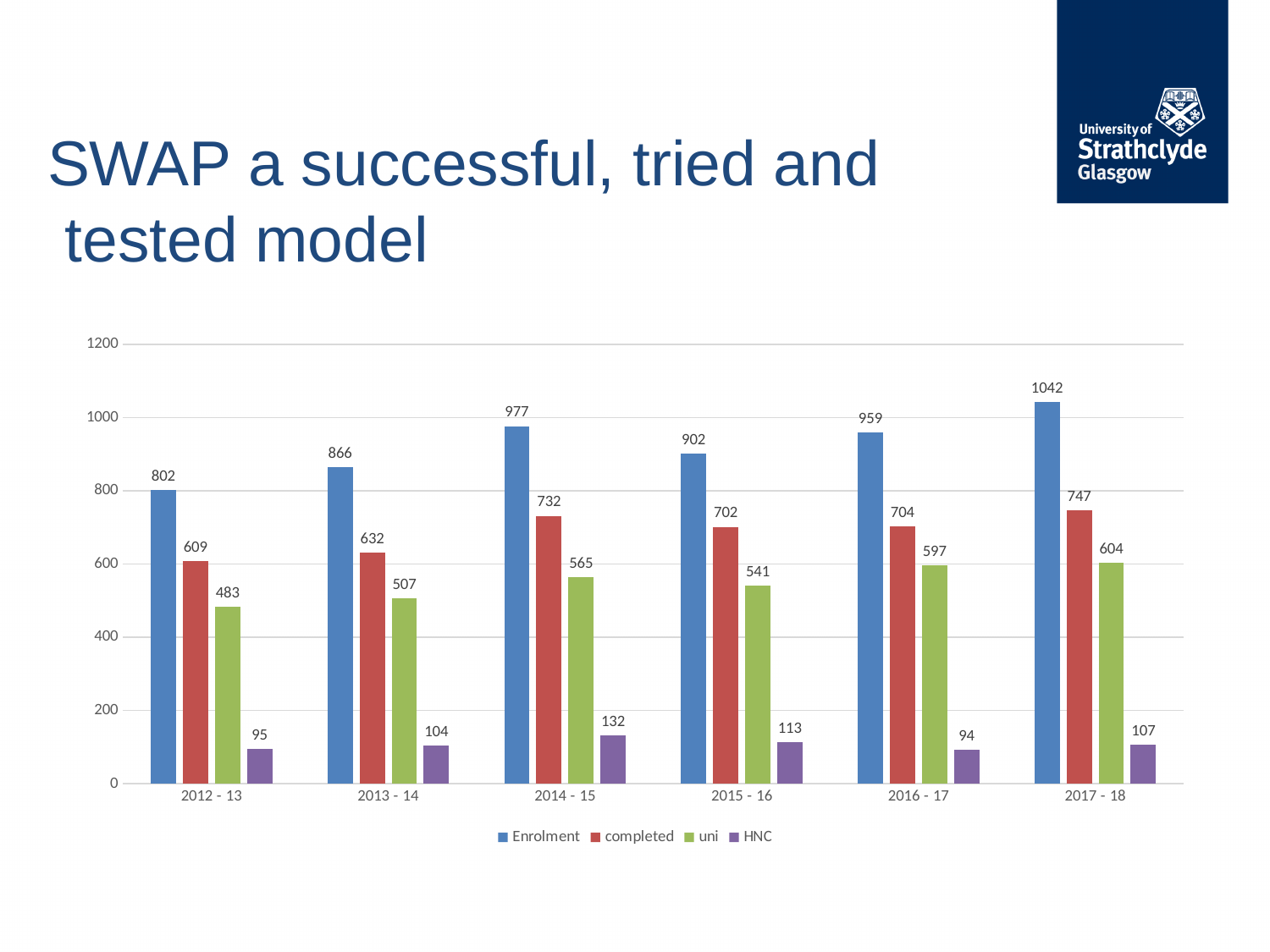
What is the difference between Enrolment and completed in 2015 - 16? 200 Which year has the lowest uni value? 2012 - 13 What is the Enrolment value for 2017 - 18? 1042 Which is larger, the uni value for 2016 - 17 or the uni value for 2017 - 18? 2017 - 18 What is the completed value for 2014 - 15? 732 What is the HNC value for 2016 - 17? 94 What kind of chart is shown on the slide? Bar chart Which year has the highest Enrolment value? 2017 - 18 How many series does the legend list? 4 How many year categories are shown on the x axis? 6 Does the Enrolment series rise or fall from 2014 - 15 to 2015 - 16? Fall Is the Enrolment value for 2013 - 14 greater or less than 800? greater